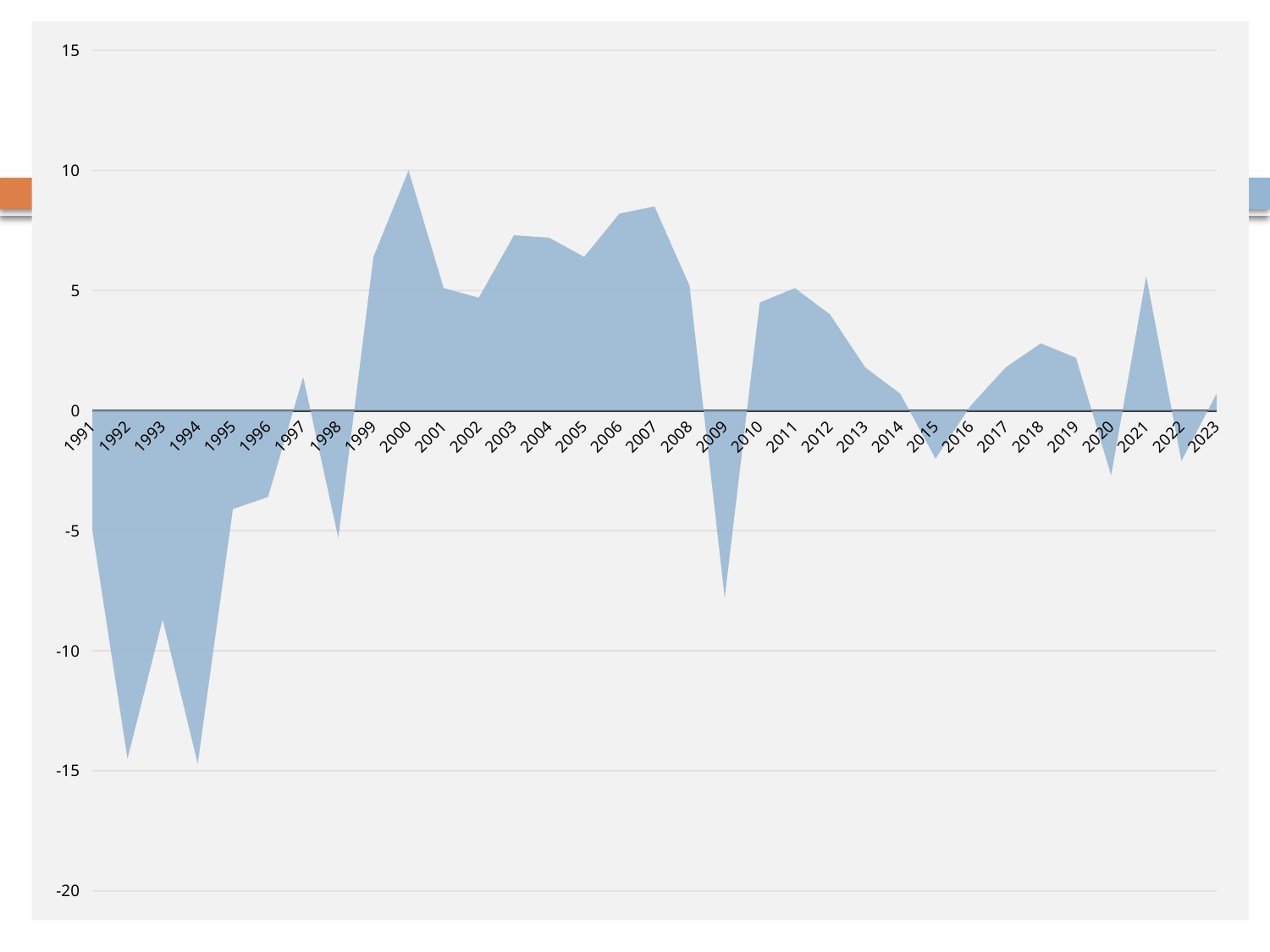
How many years are plotted along the x axis? 33 Do the values rise or fall from 1994 to 1997? rise Is the value for 2007 greater or less than 5? greater Which is larger, the value for 2000 or the value for 2007? 2000 Which is larger, the value for 2009 or the value for 2015? 2015 Is the value for 2000 greater or less than 5? greater Is the value for 1992 greater or less than -10? less What kind of chart is shown on the slide? area chart Do the values rise or fall from 2000 to 2002? fall Which year has the highest value? 2000